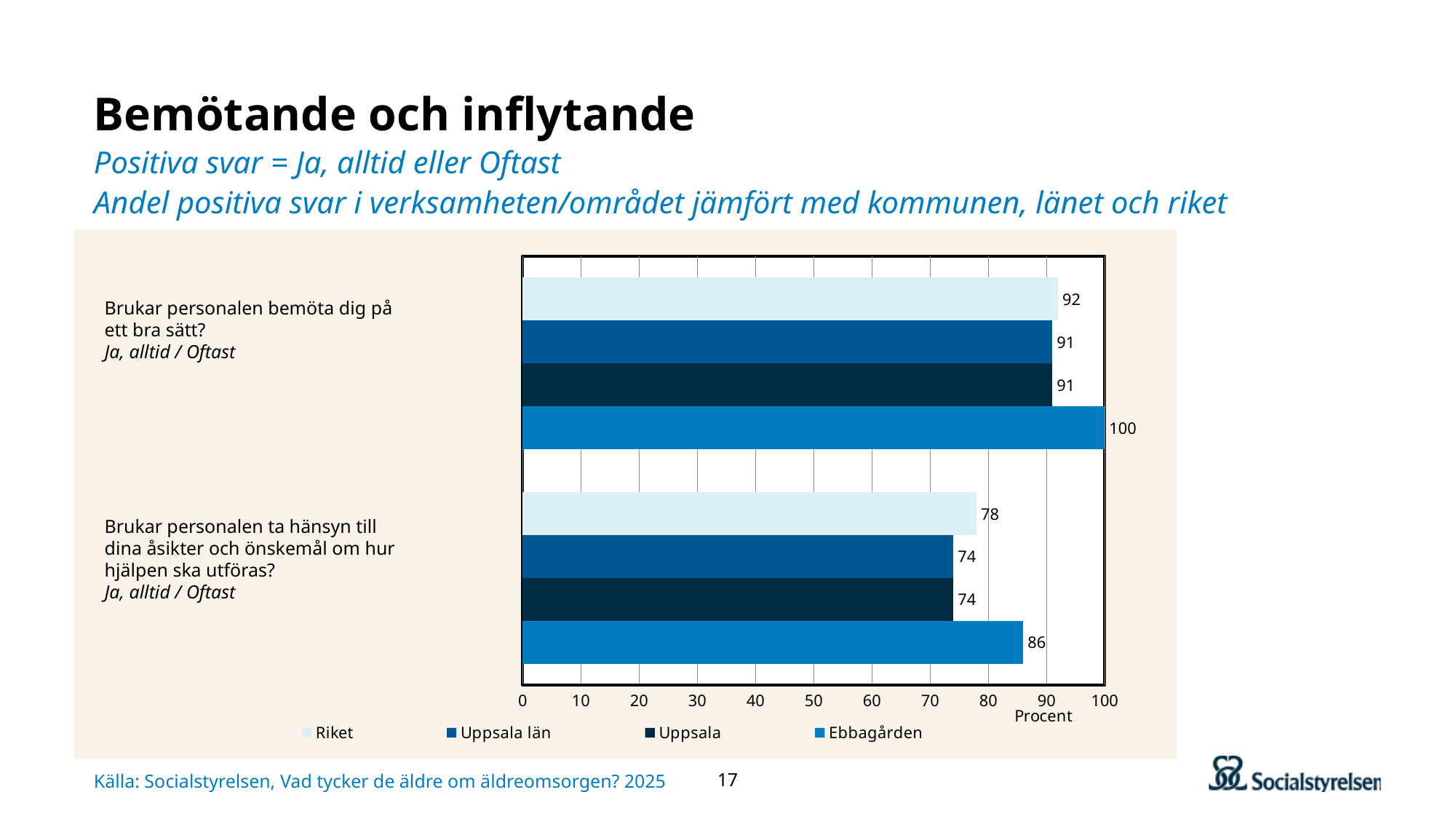
Which series has the highest value on the question "Brukar personalen ta hänsyn till dina åsikter och önskemål om hur hjälpen ska utföras?"? Ebbagården What unit is shown on the x axis of the chart? Procent What is the value for Uppsala on the question "Brukar personalen ta hänsyn till dina åsikter och önskemål om hur hjälpen ska utföras?"? 74 What is the value for Riket on the question "Brukar personalen ta hänsyn till dina åsikter och önskemål om hur hjälpen ska utföras?"? 78 What is the difference between Ebbagården and Uppsala on the question "Brukar personalen bemöta dig på ett bra sätt?"? 9 What is the value for Uppsala län on the question "Brukar personalen bemöta dig på ett bra sätt?"? 91 Which series has the lowest value on the question "Brukar personalen bemöta dig på ett bra sätt?"? Uppsala län and Uppsala (both 91) What is the value for Ebbagården on the question "Brukar personalen bemöta dig på ett bra sätt?"? 100 What kind of chart is shown on the slide? Bar chart What is the difference between Ebbagården and Riket on the question "Brukar personalen ta hänsyn till dina åsikter och önskemål om hur hjälpen ska utföras?"? 8 Which is larger: Riket or Uppsala län on the question "Brukar personalen ta hänsyn till dina åsikter och önskemål om hur hjälpen ska utföras?"? Riket How many series does the legend list? 4